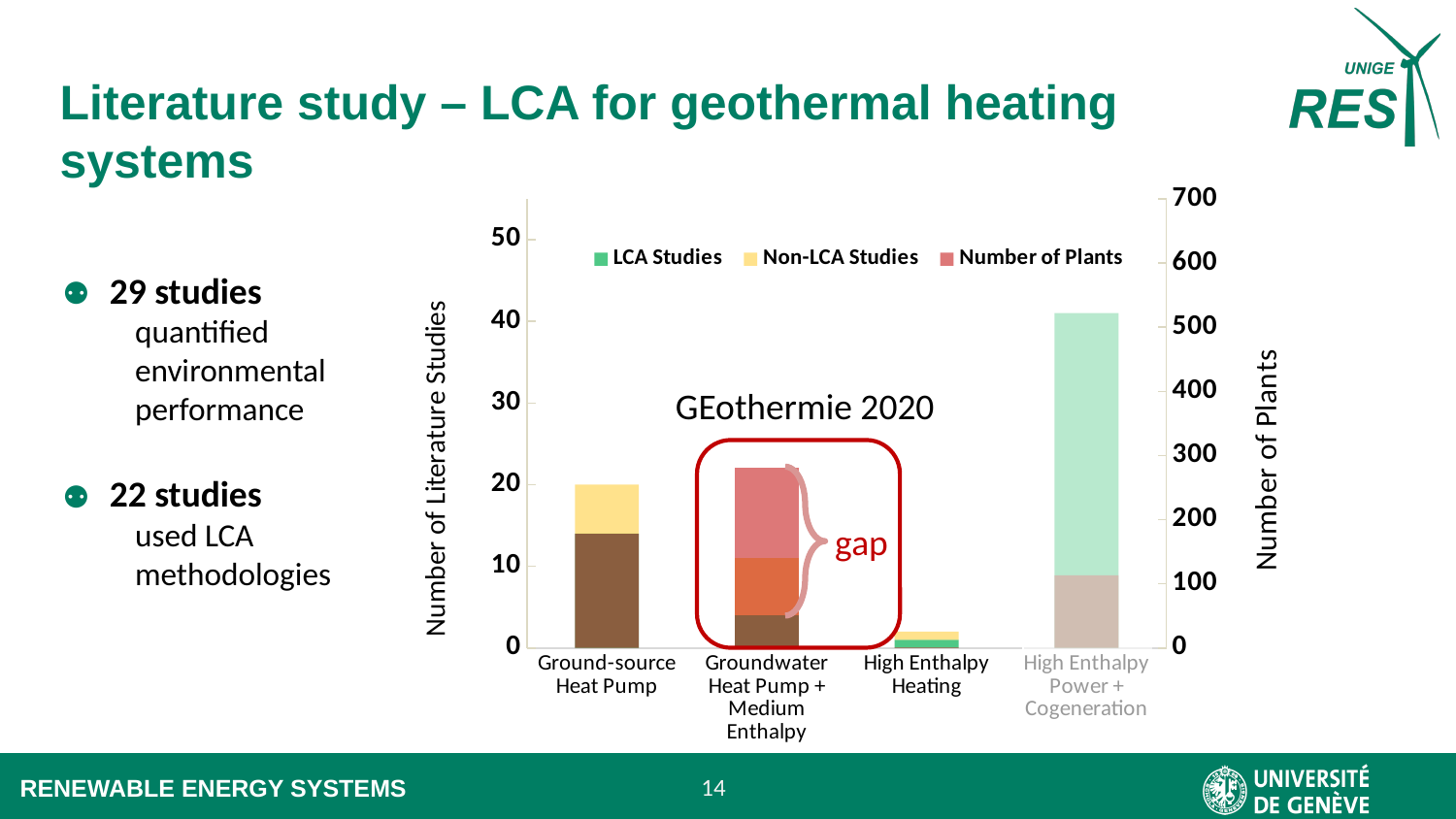
Which category has the tallest bar in the chart? High Enthalpy Power + Cogeneration Is the total bar height for Ground-source Heat Pump greater or less than 10 on the left axis? greater What is the title of the right vertical axis of the chart? Number of Plants Is the total bar height for Ground-source Heat Pump greater or less than 30 on the left axis? less Which category has the shortest bar in the chart? High Enthalpy Heating Which bar is taller: Ground-source Heat Pump or High Enthalpy Heating? Ground-source Heat Pump Is the bar for High Enthalpy Power + Cogeneration greater or less than 30 on the left axis? greater What kind of chart is shown on the slide? Stacked bar chart How many categories are shown on the x axis of the chart? 4 What is the title of the left vertical axis of the chart? Number of Literature Studies How many series does the chart's legend list? 3